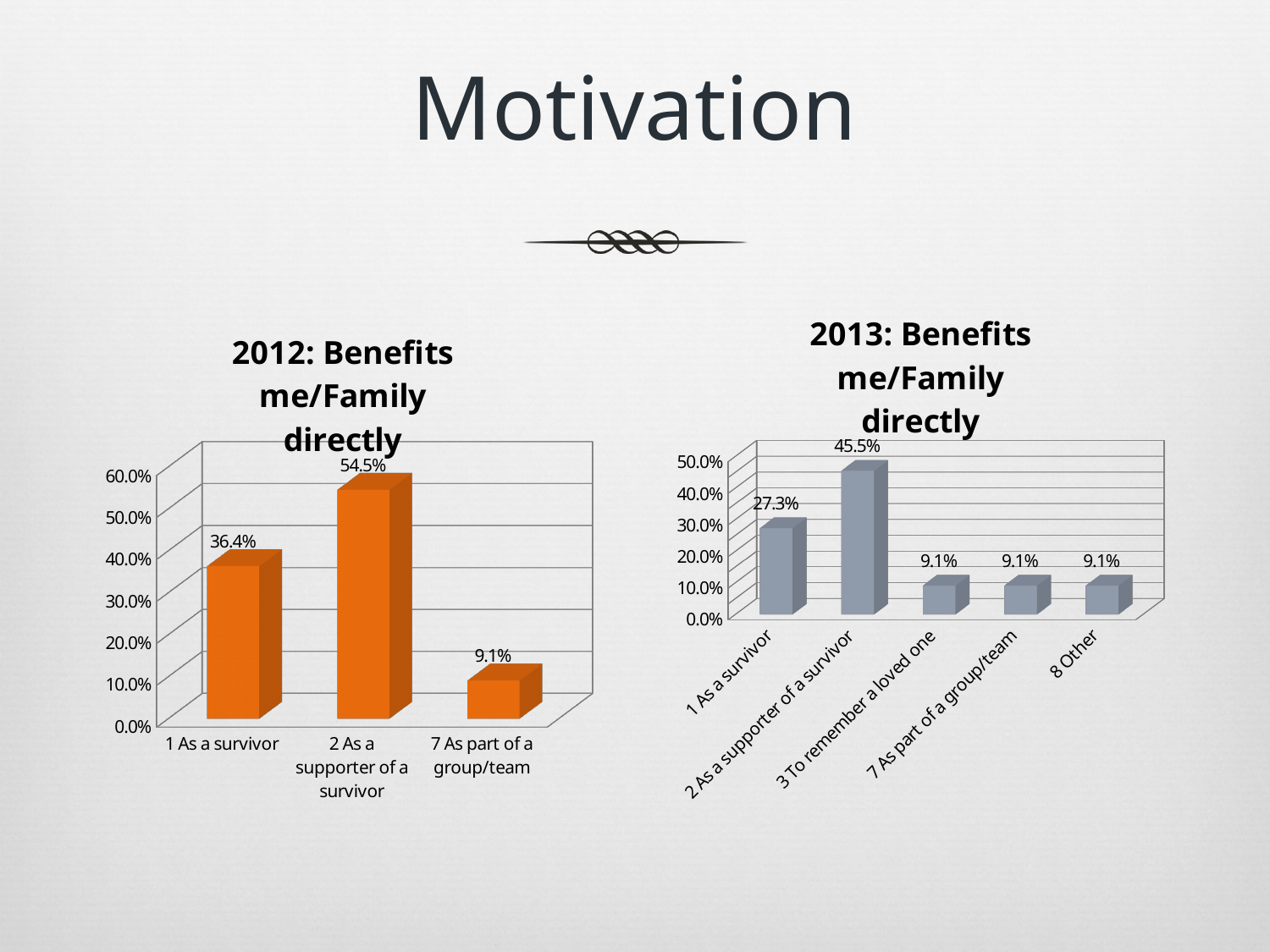
How many categories are shown in the 2012: Benefits me/Family directly chart? 3 In the 2013: Benefits me/Family directly chart, what is the difference between 2 As a supporter of a survivor and 1 As a survivor? 18.2% In the 2012: Benefits me/Family directly chart, what is the value for 2 As a supporter of a survivor? 54.5% In the 2013: Benefits me/Family directly chart, what is the value for 1 As a survivor? 27.3% In the 2012: Benefits me/Family directly chart, which category has the lowest value? 7 As part of a group/team In the 2012: Benefits me/Family directly chart, what is the value for 1 As a survivor? 36.4% In the 2012: Benefits me/Family directly chart, what is the difference between 2 As a supporter of a survivor and 1 As a survivor? 18.1% In the 2013: Benefits me/Family directly chart, what is the value for 8 Other? 9.1% What type of chart is the 2012: Benefits me/Family directly chart? Bar chart How many categories are shown in the 2013: Benefits me/Family directly chart? 5 In the 2013: Benefits me/Family directly chart, which is larger: 1 As a survivor or 3 To remember a loved one? 1 As a survivor In the 2013: Benefits me/Family directly chart, which category has the highest value? 2 As a supporter of a survivor